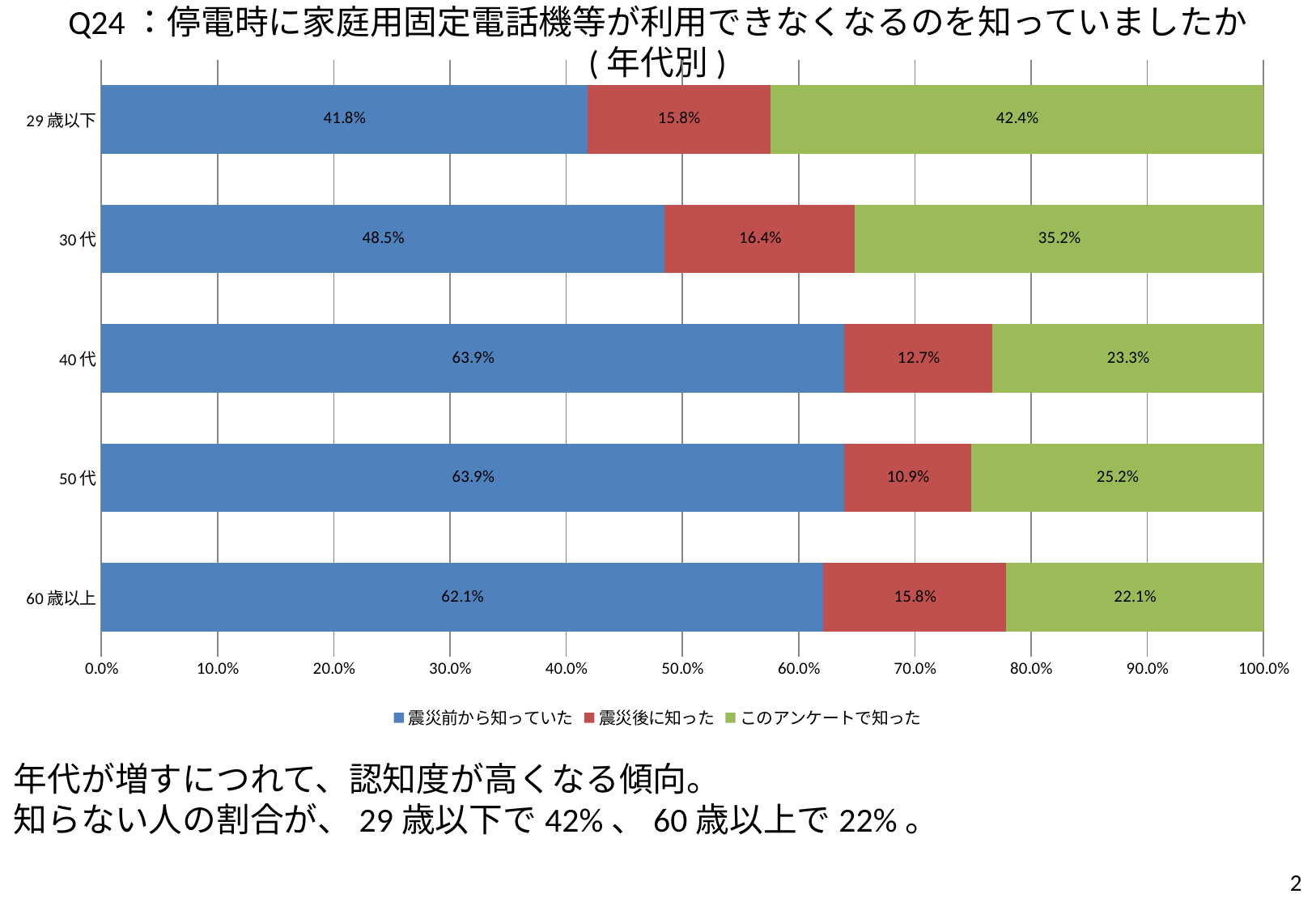
How many series does the legend list? 3 Which age category has the highest value for このアンケートで知った? 29歳以下 What is the value of 震災前から知っていた for 30代? 48.5% Which is larger: the このアンケートで知った value for 40代 or for 50代? 50代 What is the value of このアンケートで知った for 60歳以上? 22.1% How many age categories are shown in the chart? 5 What is the difference between the このアンケートで知った values for 29歳以下 and 60歳以上? 20.3 percentage points Which age category has the lowest value for 震災前から知っていた? 29歳以下 What type of chart is shown on the slide? Stacked bar chart Which age category has the lowest value for 震災後に知った? 50代 What is the total of the stacked bar for 29歳以下? 100.0% What is the value of 震災後に知った for 40代? 12.7%